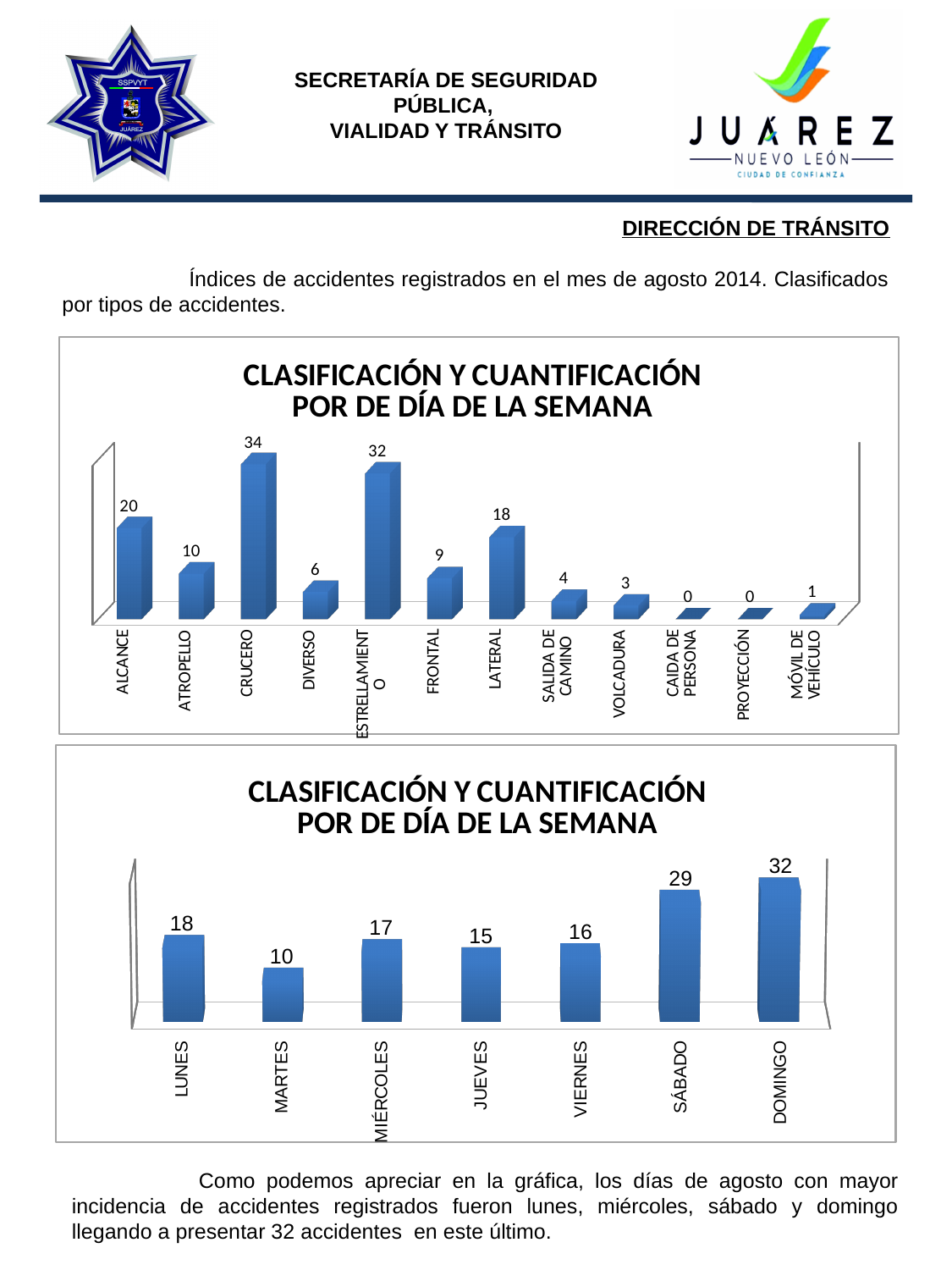
In the top chart, how many accident categories are shown on the x axis? 12 In the bottom chart, which day has the lowest value? MARTES In the top chart, which categories have a value of 0? CAIDA DE PERSONA and PROYECCIÓN What type of chart is the bottom chart? Bar chart In the top chart, what is the value for ESTRELLAMIENTO? 32 In the bottom chart, how many days are shown on the x axis? 7 In the top chart, which is larger, LATERAL or FRONTAL? LATERAL In the top chart, how many accidents are recorded for CRUCERO? 34 In the bottom chart, what is the value for DOMINGO? 32 In the top chart, what is the difference between the values for ALCANCE and ATROPELLO? 10 In the bottom chart, what is the difference between SÁBADO and VIERNES? 13 In the top chart, which accident type has the highest value? CRUCERO